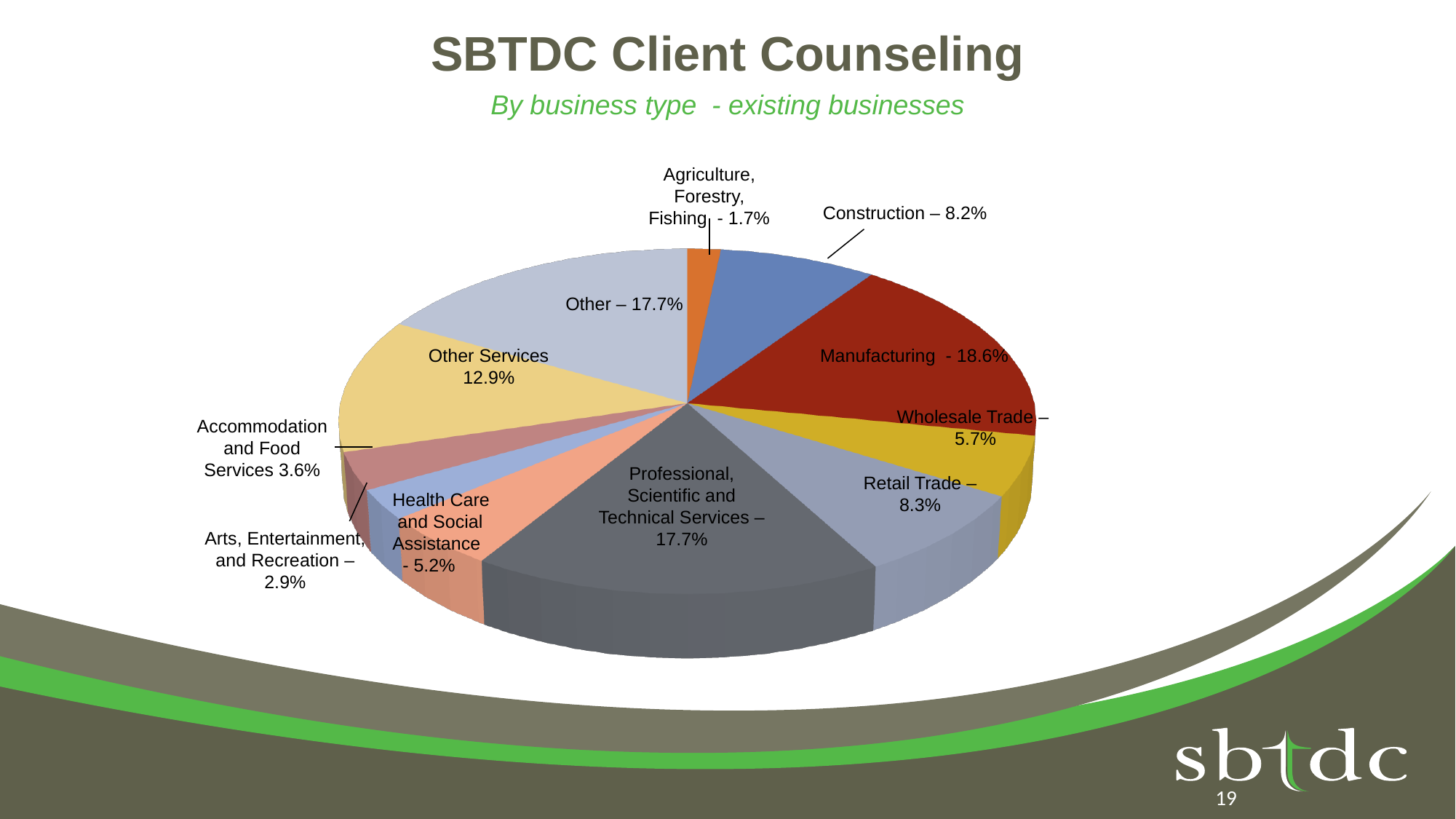
What is the subtitle of the chart slide? By business type - existing businesses What is the combined share of Other and Professional, Scientific and Technical Services? 35.4% What share of client counseling is for Wholesale Trade? 5.7% What kind of chart is shown on the slide? Pie chart Which has a larger share, Retail Trade or Construction? Retail Trade Which business type has the largest share of the pie? Manufacturing What is the difference in percentage points between Manufacturing and Construction? 10.4 Which business type has the smallest share of the pie? Agriculture, Forestry, Fishing How many business types (slices) are shown in the pie chart? 11 What share of client counseling is for Other Services? 12.9% What share of client counseling is for Manufacturing? 18.6% What share of client counseling is for Health Care and Social Assistance? 5.2%